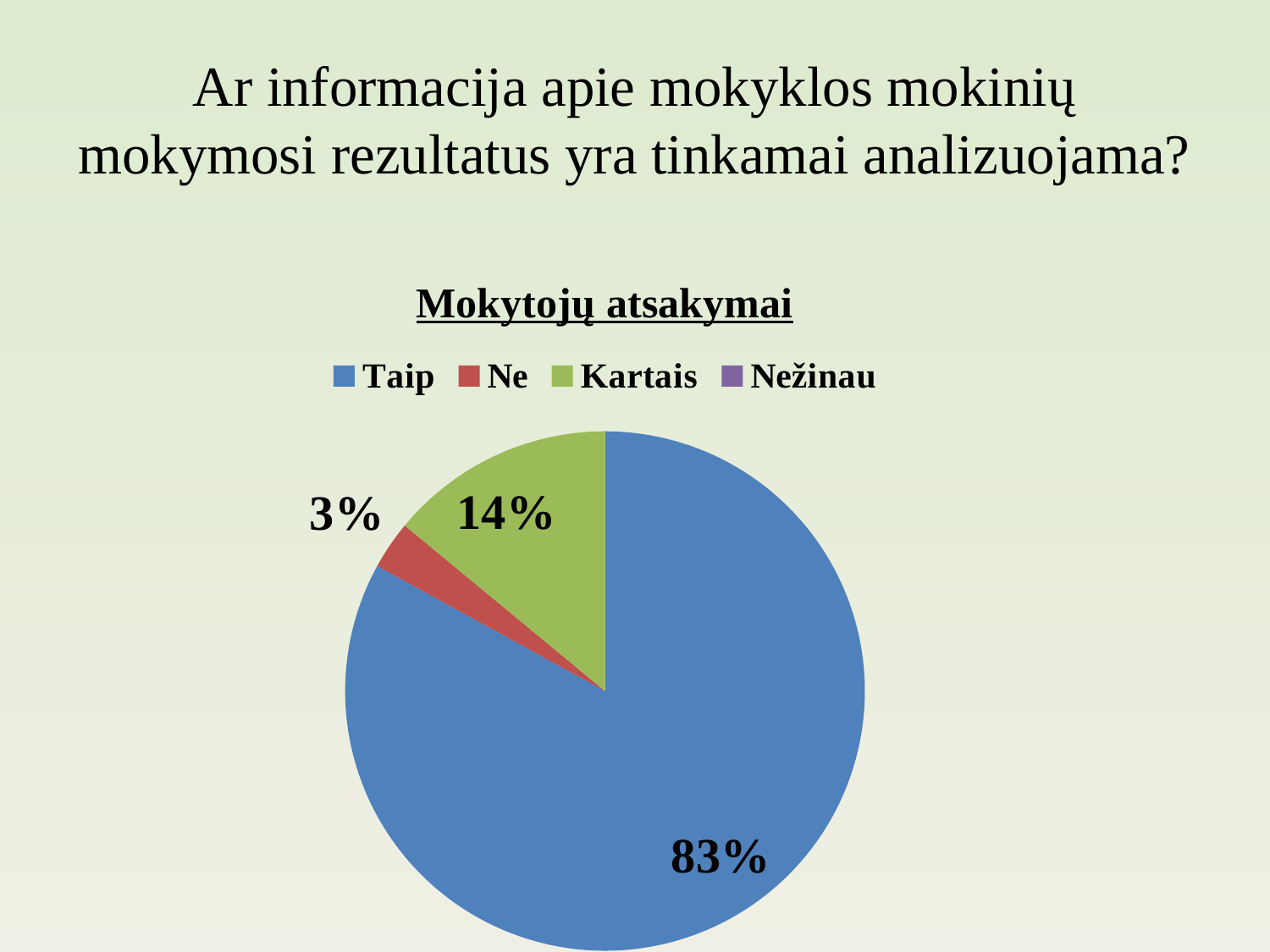
Which legend entry is shown in green? Kartais What percentage of the pie is labelled for Taip? 83% Which category has the largest slice of the pie? Taip What percentage of the pie is labelled for Ne? 3% What is the title of the chart? Mokytojų atsakymai Which of the visible slices is the smallest? Ne How many entries does the chart legend list? 4 What is the difference in percentage points between Taip and Kartais? 69 What is the combined share of Ne and Kartais? 17% What kind of chart is shown on the slide? pie chart What percentage of the pie is labelled for Kartais? 14% Which is larger, the Kartais slice or the Ne slice? Kartais